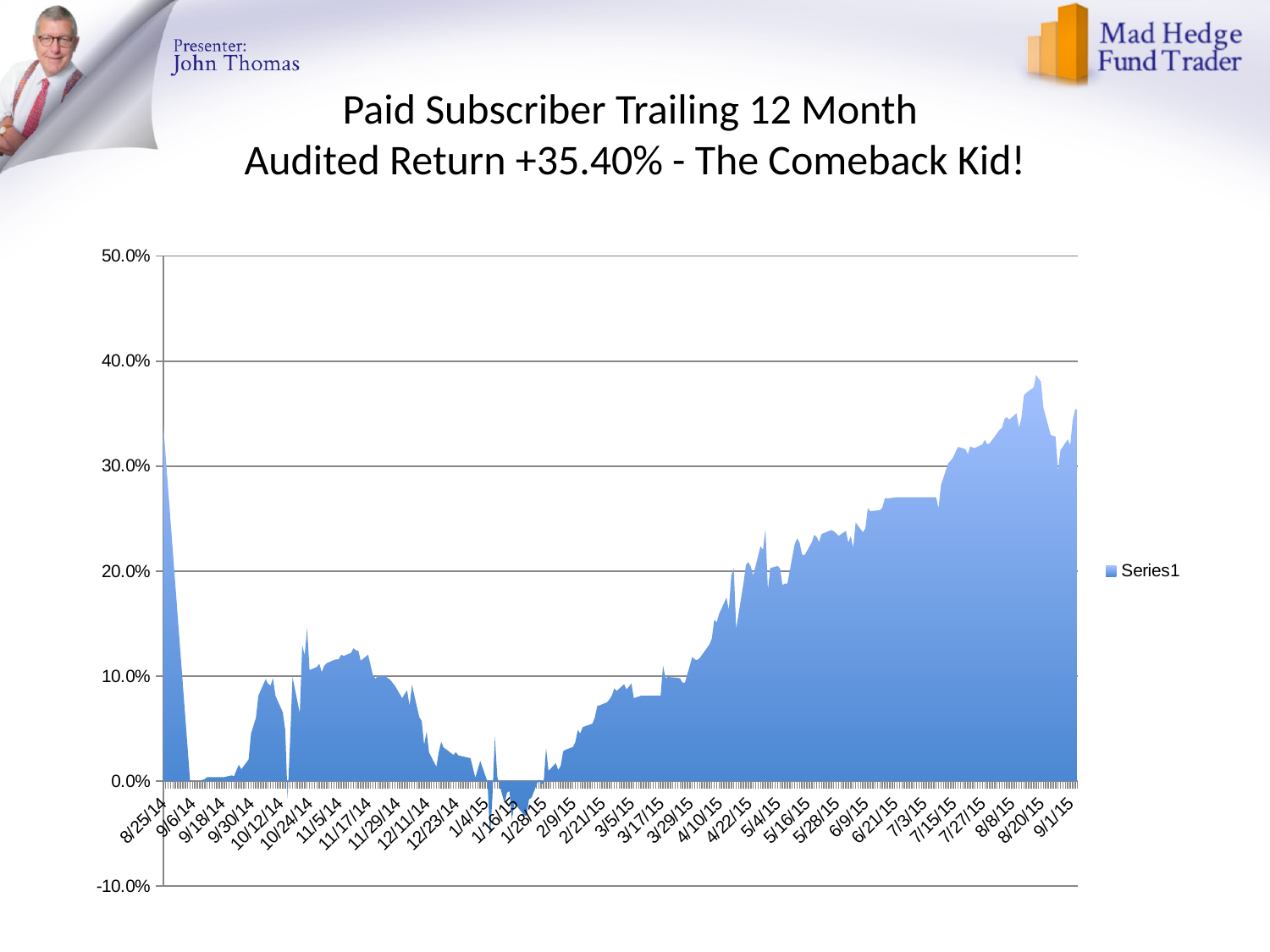
Is the value for 11/17/14 greater or less than 20.0%? less What is the name of the series shown in the legend? Series1 Is the value for 6/9/15 greater or less than 20.0%? greater What is the title of the chart's slide? Paid Subscriber Trailing 12 Month Audited Return +35.40% - The Comeback Kid! What kind of chart is shown on the slide? Area chart Which is larger, the value for 8/8/15 or the value for 12/23/14? 8/8/15 Does the value generally rise or fall between 1/28/15 and 8/8/15? rise What is the highest value shown on the y axis? 50.0% Is the value for 9/1/15 greater or less than 30.0%? greater How many series does the legend list? 1